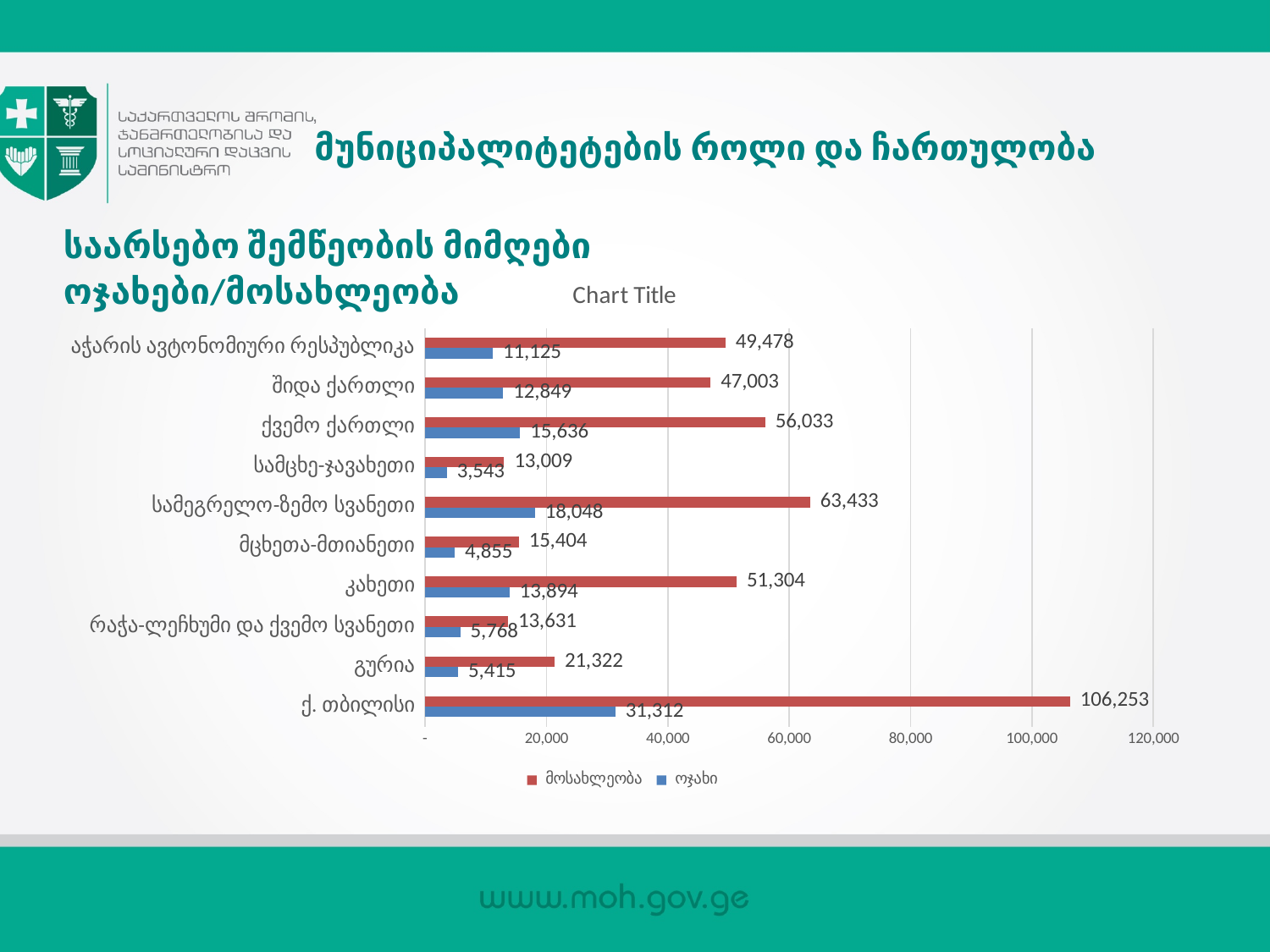
What is the ოჯახი value for სამეგრელო-ზემო სვანეთი? 18,048 Which is larger, the მოსახლეობა value for კახეთი or for აჭარის ავტონომიური რესპუბლიკა? კახეთი What title is printed above the chart? Chart Title What is the მოსახლეობა value for ქ. თბილისი? 106,253 What is the difference between the მოსახლეობა values for ქვემო ქართლი and შიდა ქართლი? 9,030 Which region has the highest მოსახლეობა value? ქ. თბილისი What is the მოსახლეობა value for გურია? 21,322 Is the მოსახლეობა value for ქ. თბილისი greater or less than 100,000? greater What type of chart is shown on the slide? bar chart How many categories (regions) are shown on the chart? 10 Which region has the lowest ოჯახი value? სამცხე-ჯავახეთი How many series does the chart legend list? 2